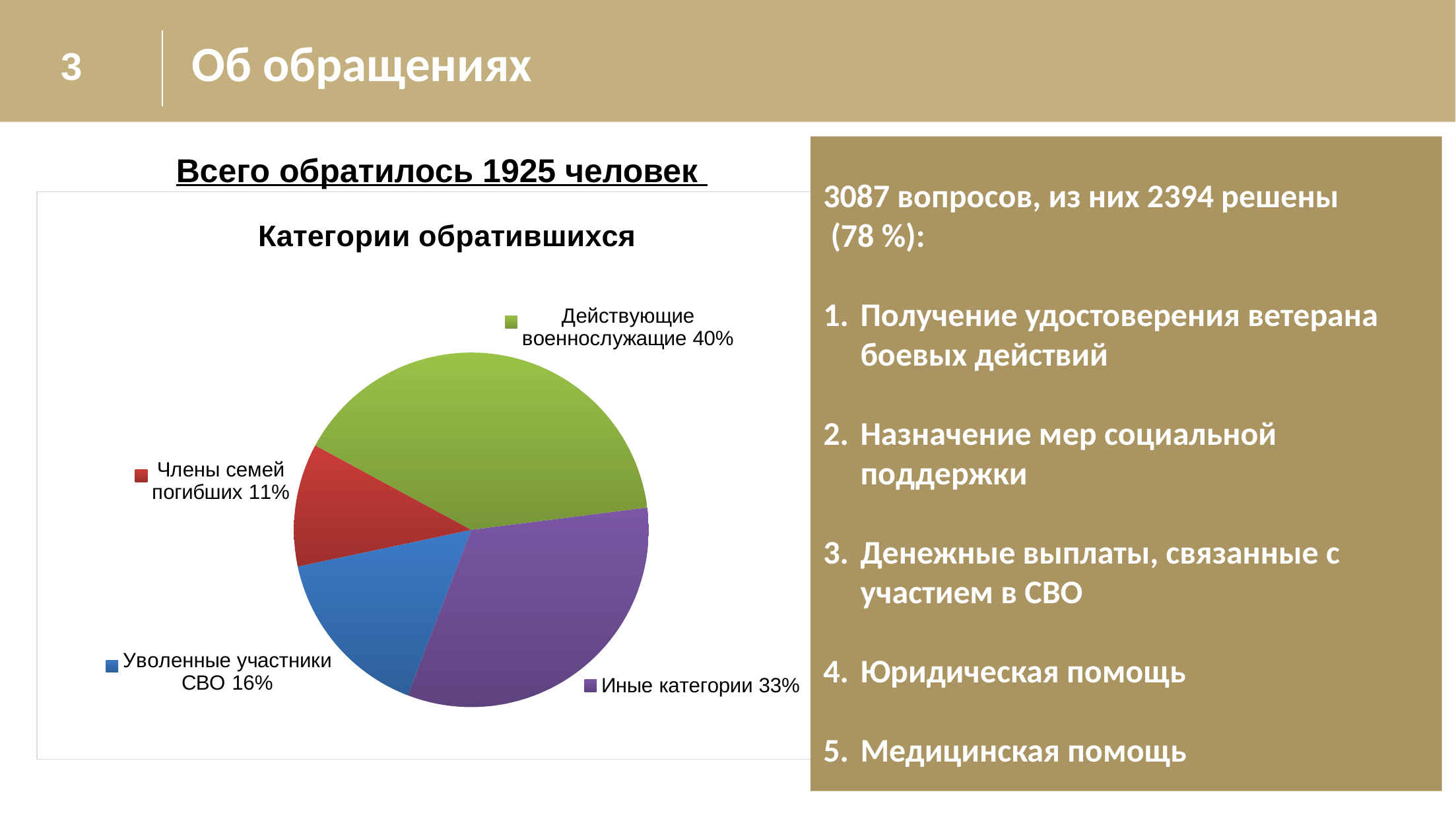
What share of the pie is 'Уволенные участники СВО'? 16% What type of chart is shown on the slide? pie chart Which category has the smallest share of the pie? Члены семей погибших Which is larger: the share for 'Уволенные участники СВО' or the share for 'Члены семей погибших'? Уволенные участники СВО What colour is the slice for 'Иные категории'? purple What share of the pie is 'Члены семей погибших'? 11% What share of the pie is 'Действующие военнослужащие'? 40% What is the difference in percentage points between 'Действующие военнослужащие' and 'Иные категории'? 7 What is the title of the chart? Категории обратившихся How many categories does the pie chart show? 4 Which category has the largest share of the pie? Действующие военнослужащие